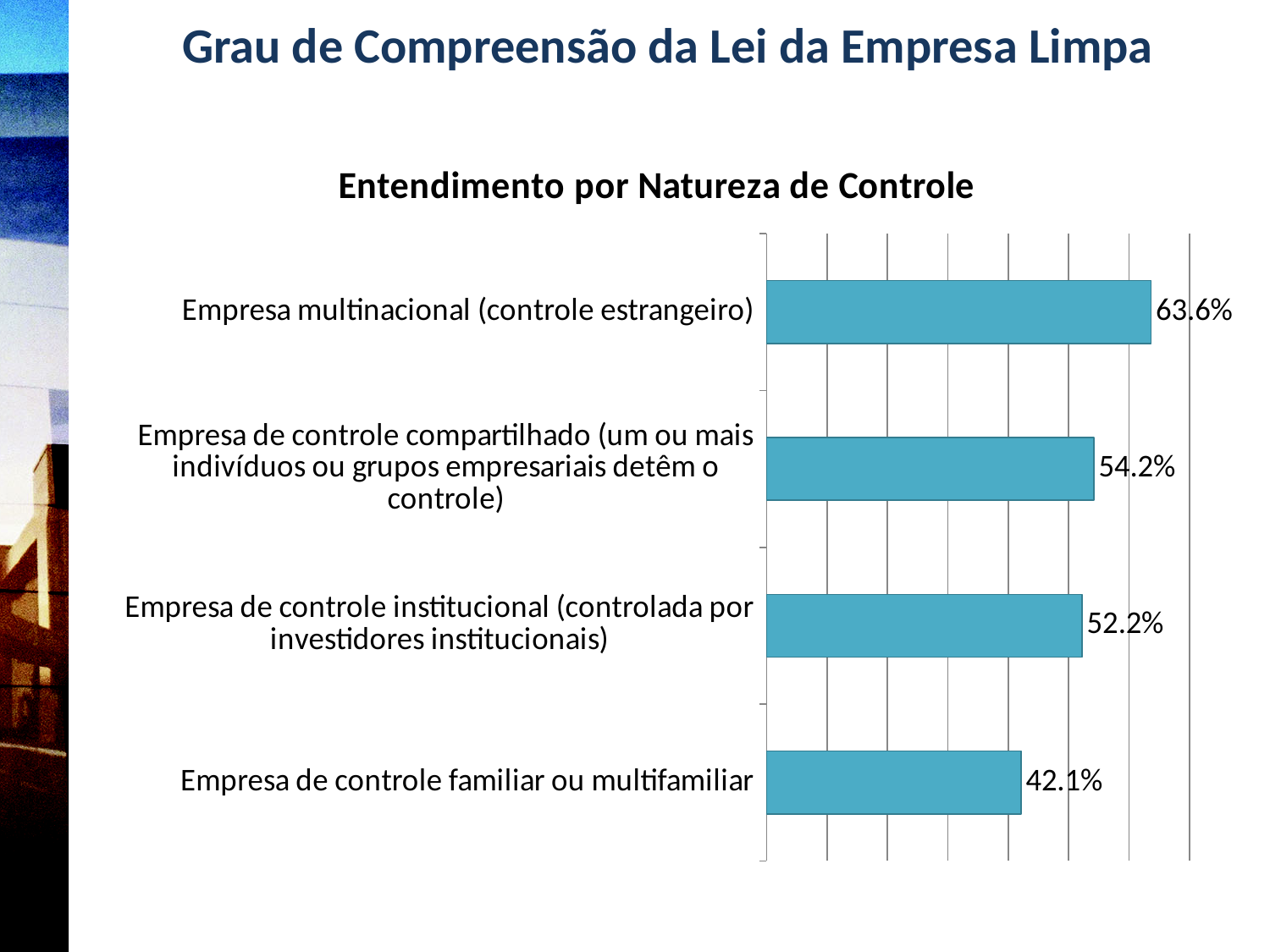
What is the value for Empresa multinacional (controle estrangeiro)? 63.6% Which is larger, the value for Empresa de controle compartilhado or Empresa de controle institucional? Empresa de controle compartilhado What is the value for Empresa de controle familiar ou multifamiliar? 42.1% Which category has the highest value? Empresa multinacional (controle estrangeiro) What is the difference between the values for Empresa de controle compartilhado and Empresa de controle institucional? 2.0% What is the difference between the values for Empresa multinacional (controle estrangeiro) and Empresa de controle familiar ou multifamiliar? 21.5% What is the value for Empresa de controle institucional (controlada por investidores institucionais)? 52.2% How many categories are shown in the chart? 4 Which category has the lowest value? Empresa de controle familiar ou multifamiliar What is the value for Empresa de controle compartilhado? 54.2% What is the title of the chart? Entendimento por Natureza de Controle What kind of chart is shown on the slide? Bar chart